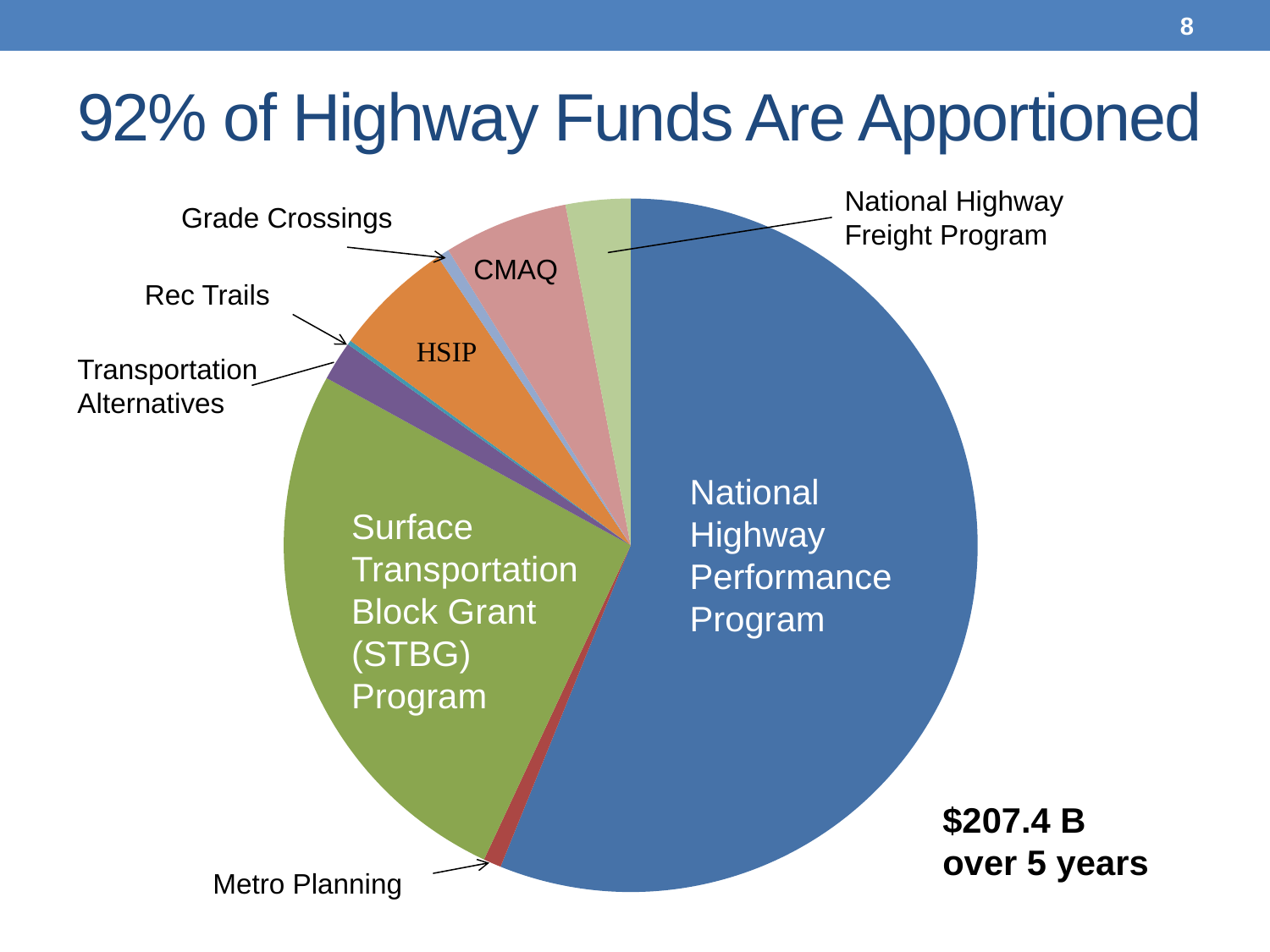
Which program has the largest slice of the pie chart? National Highway Performance Program What total funding amount is stated next to the pie chart? $207.4 B over 5 years Which slice is larger, Surface Transportation Block Grant (STBG) Program or HSIP? Surface Transportation Block Grant (STBG) Program Which slice is larger, HSIP or Metro Planning? HSIP What is the title of the slide? 92% of Highway Funds Are Apportioned Which slice is larger, CMAQ or Transportation Alternatives? CMAQ How many slices does the pie chart have? 9 What kind of chart is shown on the slide? Pie chart